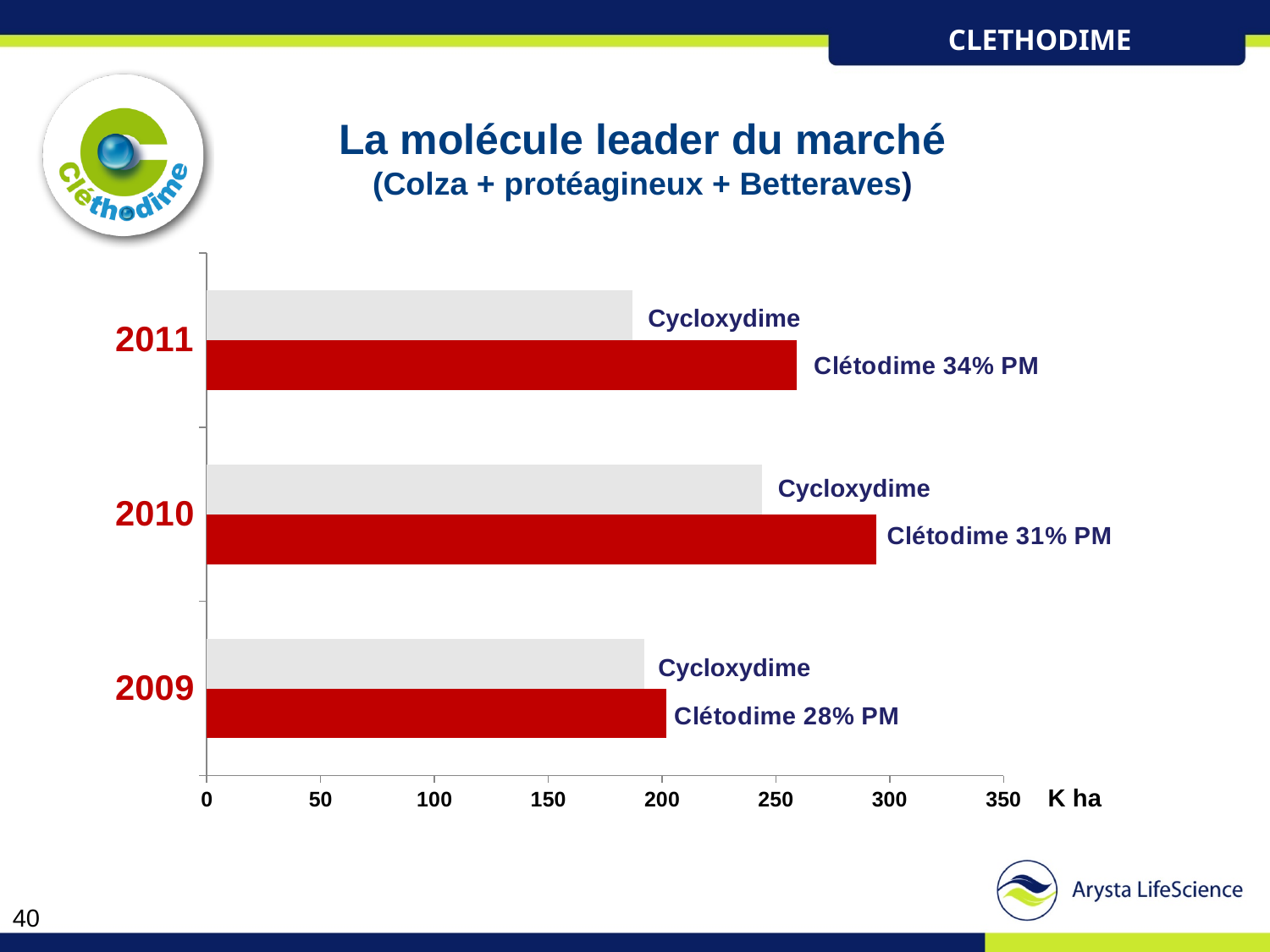
What unit is shown at the end of the horizontal axis? K ha In which year is the Cycloxydime bar the longest? 2010 In which year is the Clétodime bar the longest? 2010 What market share (PM) is labelled for Clétodime in 2009? 28% PM Which is larger in 2011: the Clétodime bar or the Cycloxydime bar? Clétodime How many years are shown on the chart? 3 What market share (PM) is labelled for Clétodime in 2011? 34% PM What kind of chart is shown on the slide? bar chart What market share (PM) is labelled for Clétodime in 2010? 31% PM Does the Clétodime market share (PM) rise or fall from 2009 to 2011? rise Is the value for Cycloxydime in 2010 greater or less than 200 K ha? greater Is the value for Clétodime in 2010 greater or less than 250 K ha? greater